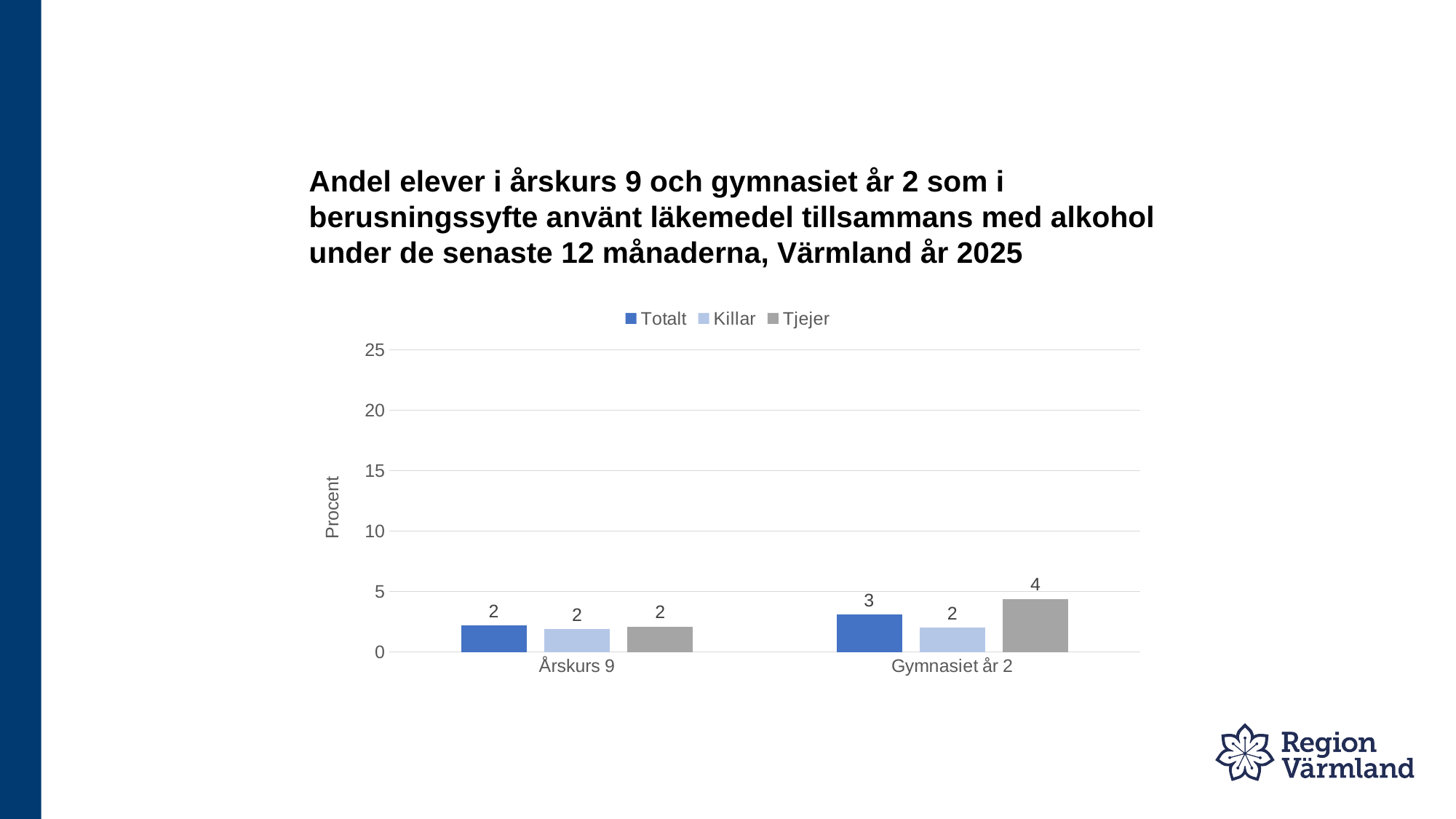
What is the value for Killar in Årskurs 9? 2 How many series does the legend list? 3 What is the difference between Tjejer and Killar in Gymnasiet år 2? 2 Which series has the highest value in Gymnasiet år 2? Tjejer What kind of chart is shown on the slide? bar chart What is the value for Totalt in Gymnasiet år 2? 3 Is the value for Tjejer in Gymnasiet år 2 greater or less than 5? less What is the label on the y axis? Procent What is the value for Tjejer in Gymnasiet år 2? 4 Does the Totalt value rise or fall from Årskurs 9 to Gymnasiet år 2? rise Which is larger: Totalt in Gymnasiet år 2 or Totalt in Årskurs 9? Totalt in Gymnasiet år 2 How many categories are shown on the x axis? 2